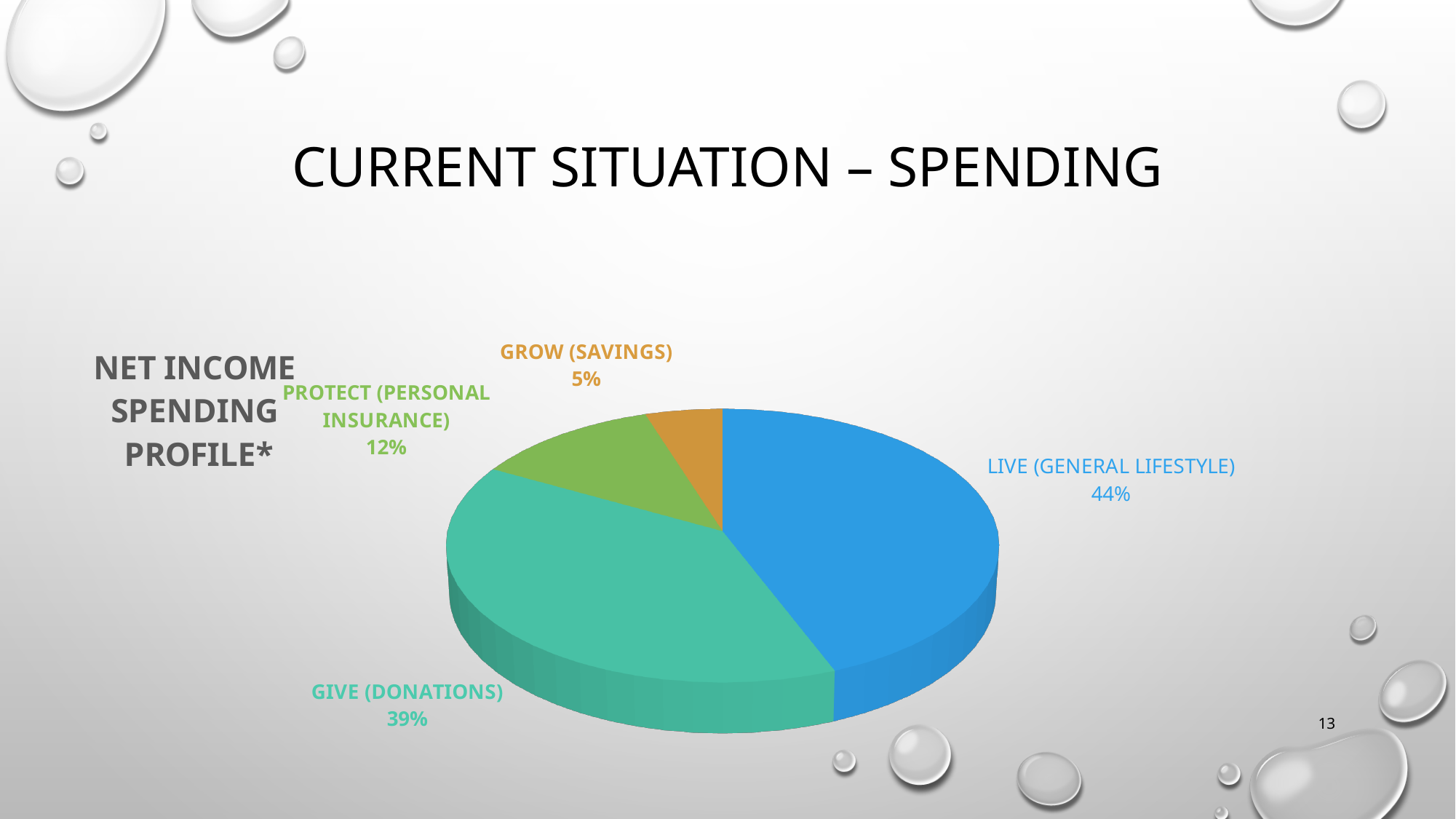
Which category has the largest share of the pie? Live (General Lifestyle) Which category has the smallest share of the pie? Grow (Savings) What kind of chart is shown on the slide? Pie chart What share of net income spending goes to Live (General Lifestyle)? 44% What share of net income spending goes to Give (Donations)? 39% How many percentage points larger is the Live (General Lifestyle) share than the Give (Donations) share? 5 How many categories does the pie chart show? 4 What is the difference in percentage points between Protect (Personal Insurance) and Grow (Savings)? 7 What share of net income spending goes to Grow (Savings)? 5% What is the title of the pie chart? Net Income Spending Profile* What share of net income spending goes to Protect (Personal Insurance)? 12% Which is larger, the share for Give (Donations) or the share for Protect (Personal Insurance)? Give (Donations)